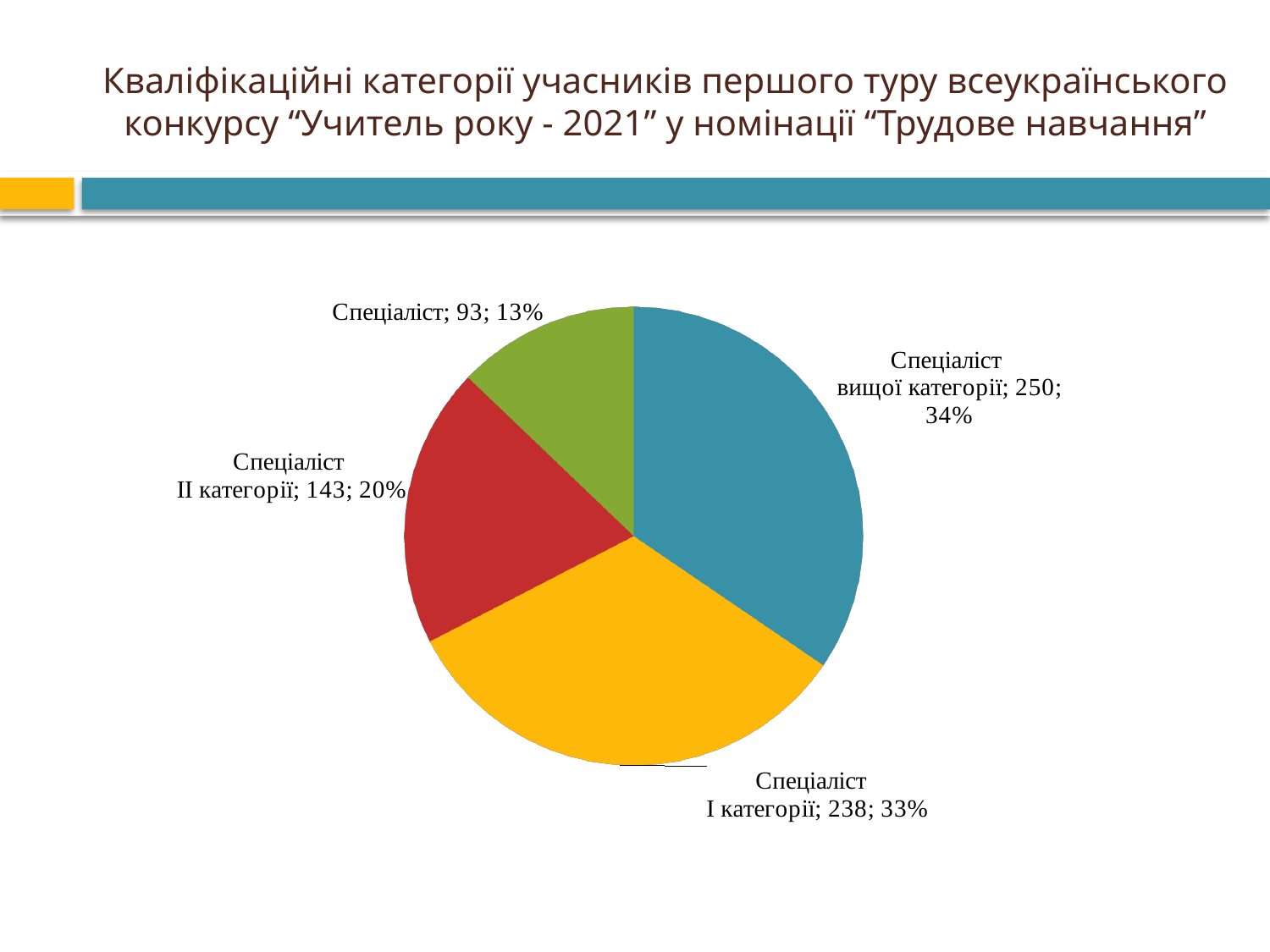
Which category has the smallest slice? Спеціаліст What is the value for Спеціаліст І категорії? 238 What share of the pie does Спеціаліст вищої категорії represent? 34% Which category has the largest slice? Спеціаліст вищої категорії What kind of chart is shown on the slide? pie chart What share of the pie does Спеціаліст ІІ категорії represent? 20% How many slices does the pie chart have? 4 What is the value for Спеціаліст? 93 What is the value for Спеціаліст ІІ категорії? 143 What is the value for Спеціаліст вищої категорії? 250 Which is larger: the value for Спеціаліст ІІ категорії or the value for Спеціаліст? Спеціаліст ІІ категорії What is the difference between the values for Спеціаліст І категорії and Спеціаліст ІІ категорії? 95